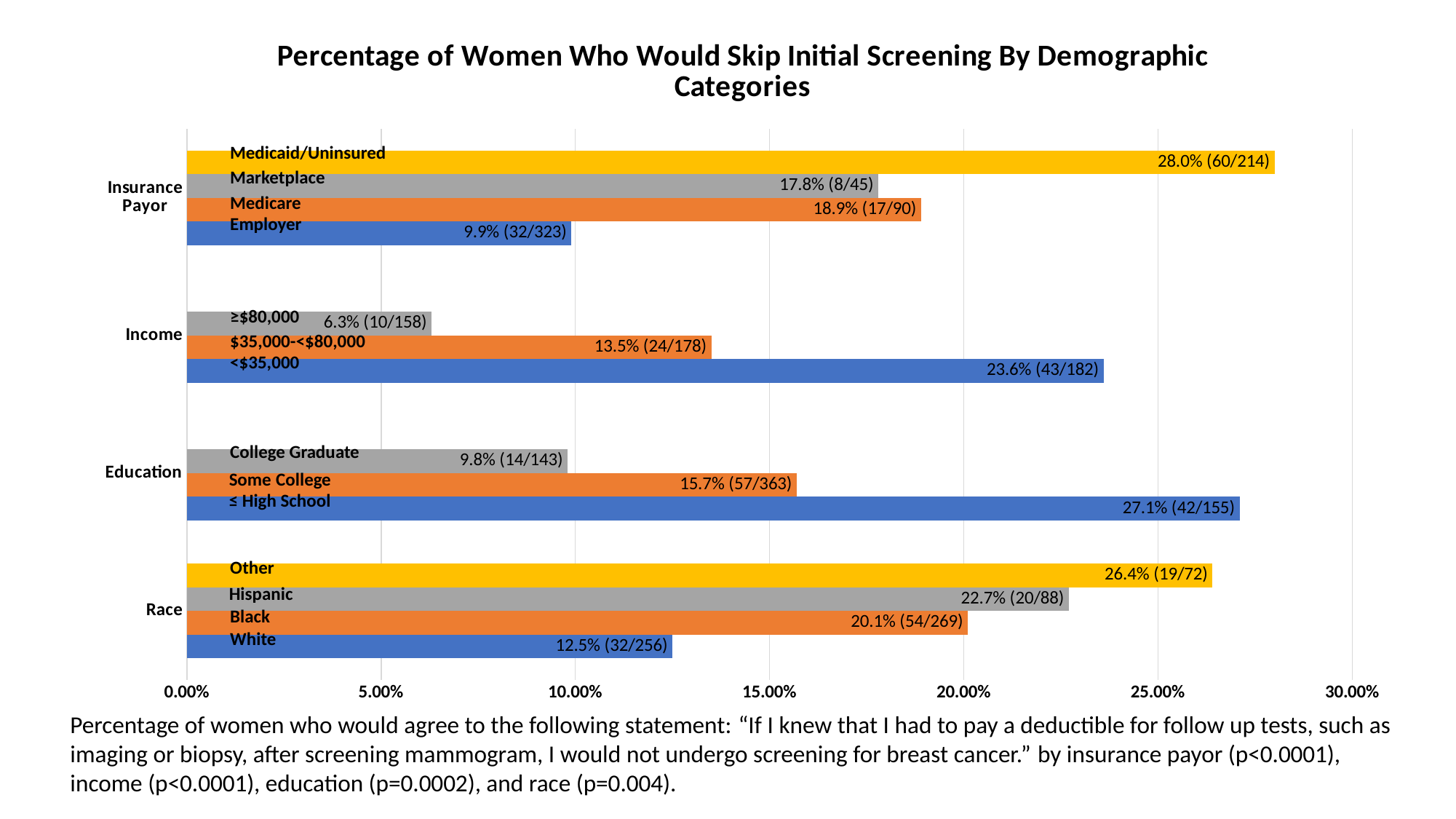
Which is larger, the percentage for Hispanic or for Black? Hispanic What percentage is shown for the <$35,000 income group? 23.6% What is the value shown for the Employer bar in the Insurance Payor group? 9.9% (32/323) Which education category has the highest percentage? ≤ High School How many bars are shown in the Race group? 4 What type of chart is shown on the slide? Bar chart Which income group has the lowest percentage of women who would skip initial screening? ≥$80,000 What is the value shown for the Some College bar? 15.7% (57/363) What percentage of women with Medicaid/Uninsured insurance would skip initial screening? 28.0% What is the difference in percentage between the Medicaid/Uninsured and Employer bars? 18.1% Which race category has the highest percentage? Other Is the value for White greater or less than 15.00%? less